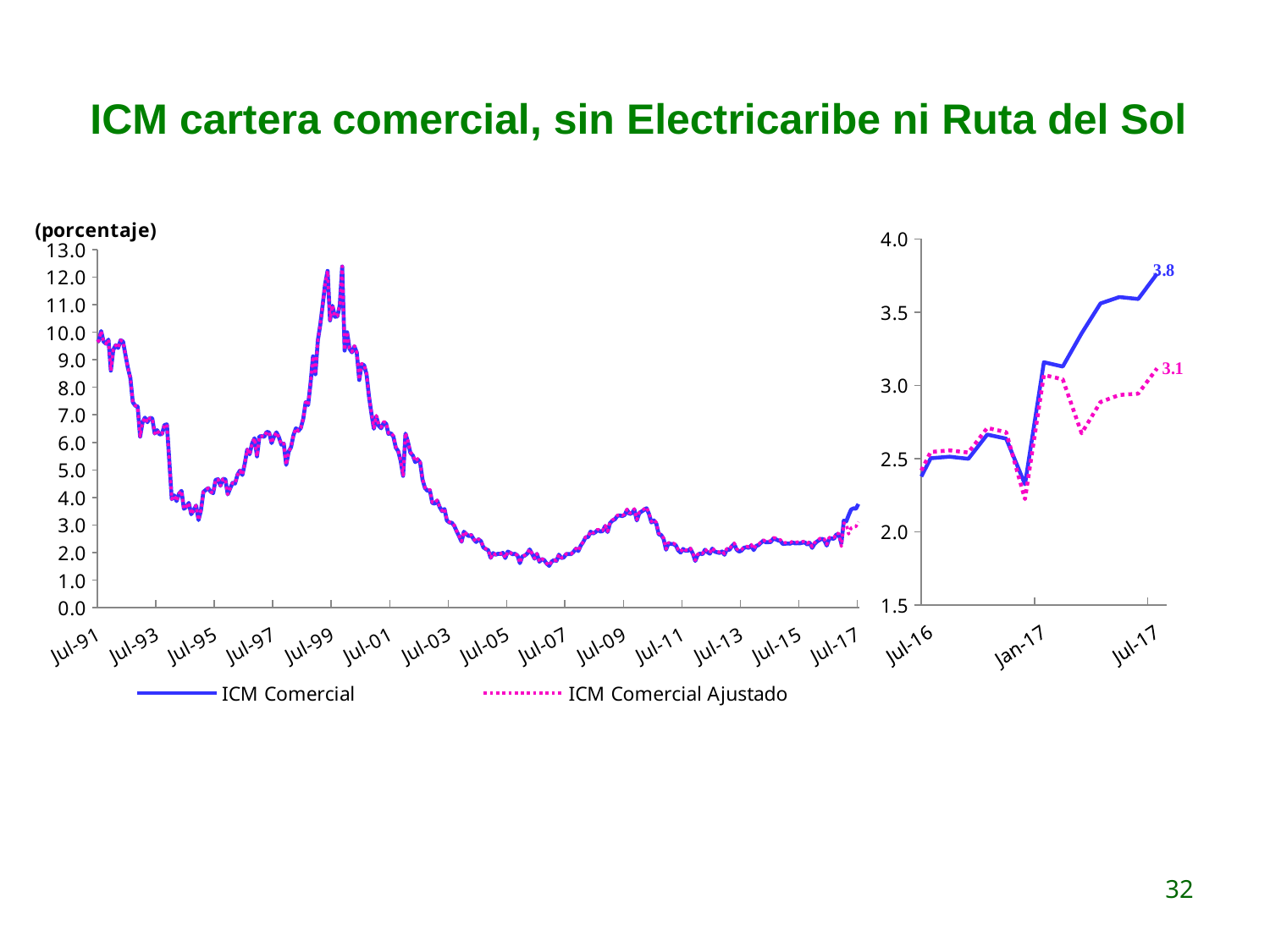
In the left-hand chart, is the value of ICM Comercial around Jul-07 greater or less than 3.0? less In the left-hand chart, do the values rise or fall between Jul-91 and Jul-95? fall In the right-hand chart (Jul-16 to Jul-17), what is the labelled final value of the ICM Comercial series? 3.8 What unit is indicated above the y axis of the left-hand chart? (porcentaje) In the right-hand chart (Jul-16 to Jul-17), what is the labelled final value of the ICM Comercial Ajustado series? 3.1 How many series does the legend below the left-hand chart list? 2 In the right-hand chart, what is the difference between the labelled final values of ICM Comercial and ICM Comercial Ajustado? 0.7 In the left-hand chart, is the peak value reached around Jul-99 greater or less than 12.0? greater In the right-hand chart, do the series generally rise or fall between Jan-17 and Jul-17? rise In the right-hand chart, which series ends higher at Jul-17, ICM Comercial or ICM Comercial Ajustado? ICM Comercial What kind of chart is the left-hand chart (Jul-91 to Jul-17)? line chart